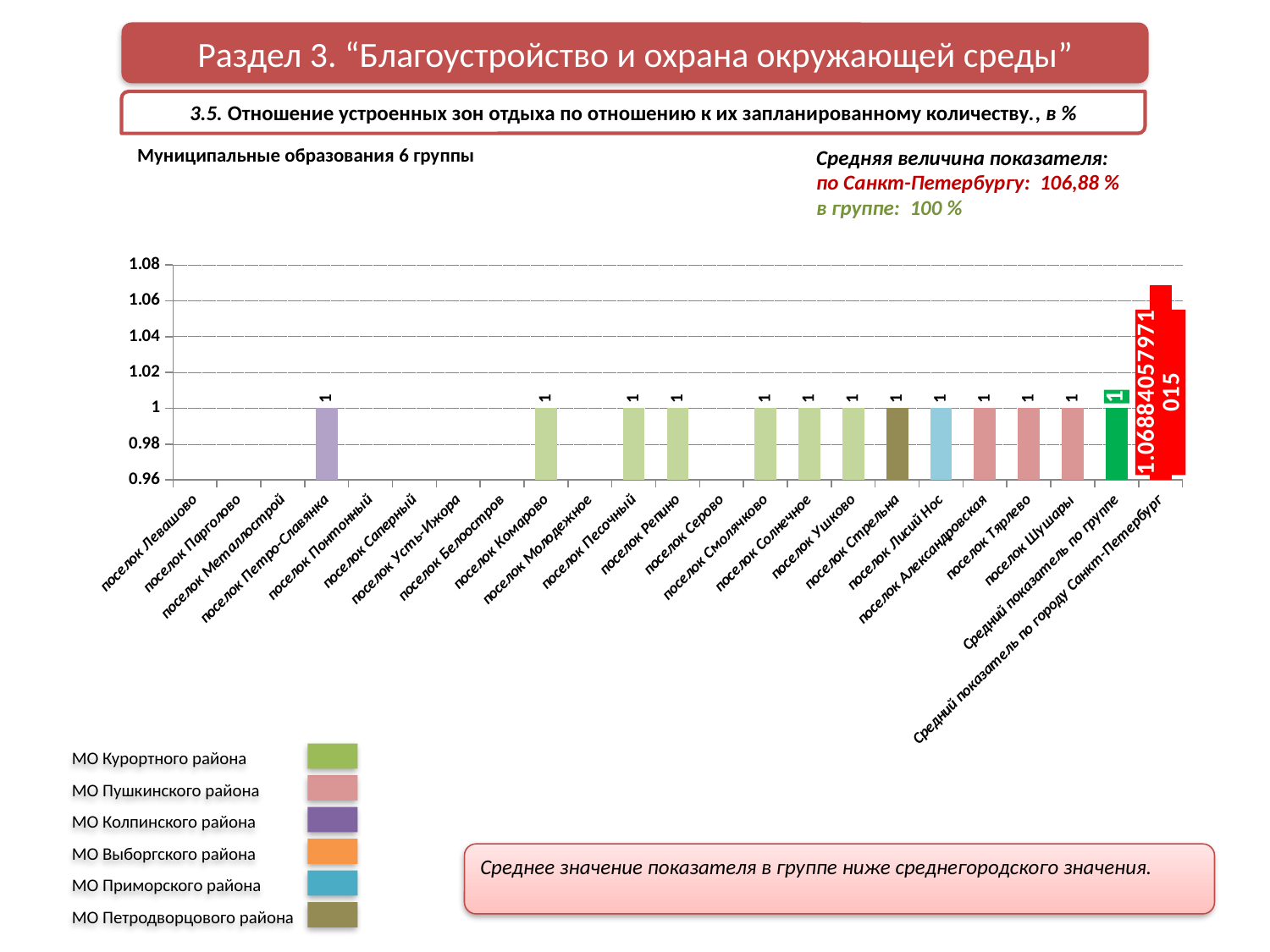
What is the value shown for Средний показатель по группе? 1 Is the value for поселок Лисий Нос greater or less than 0.98? greater Which category has the highest value in the chart? Средний показатель по городу Санкт-Петербург What is the value shown for поселок Комарово? 1 What is the value shown for поселок Шушары? 1 How many district groups does the colour legend below the chart list? 6 Which is larger: the value for Средний показатель по группе or for Средний показатель по городу Санкт-Петербург? Средний показатель по городу Санкт-Петербург According to the text on the slide, what is the average value of the indicator for Санкт-Петербург? 106,88 % What kind of chart is shown on the slide? bar chart How many categories are shown on the x axis of the chart? 23 Is the value for Средний показатель по городу Санкт-Петербург greater or less than 1.06? greater How many bars in the chart are labelled with the value 1? 13